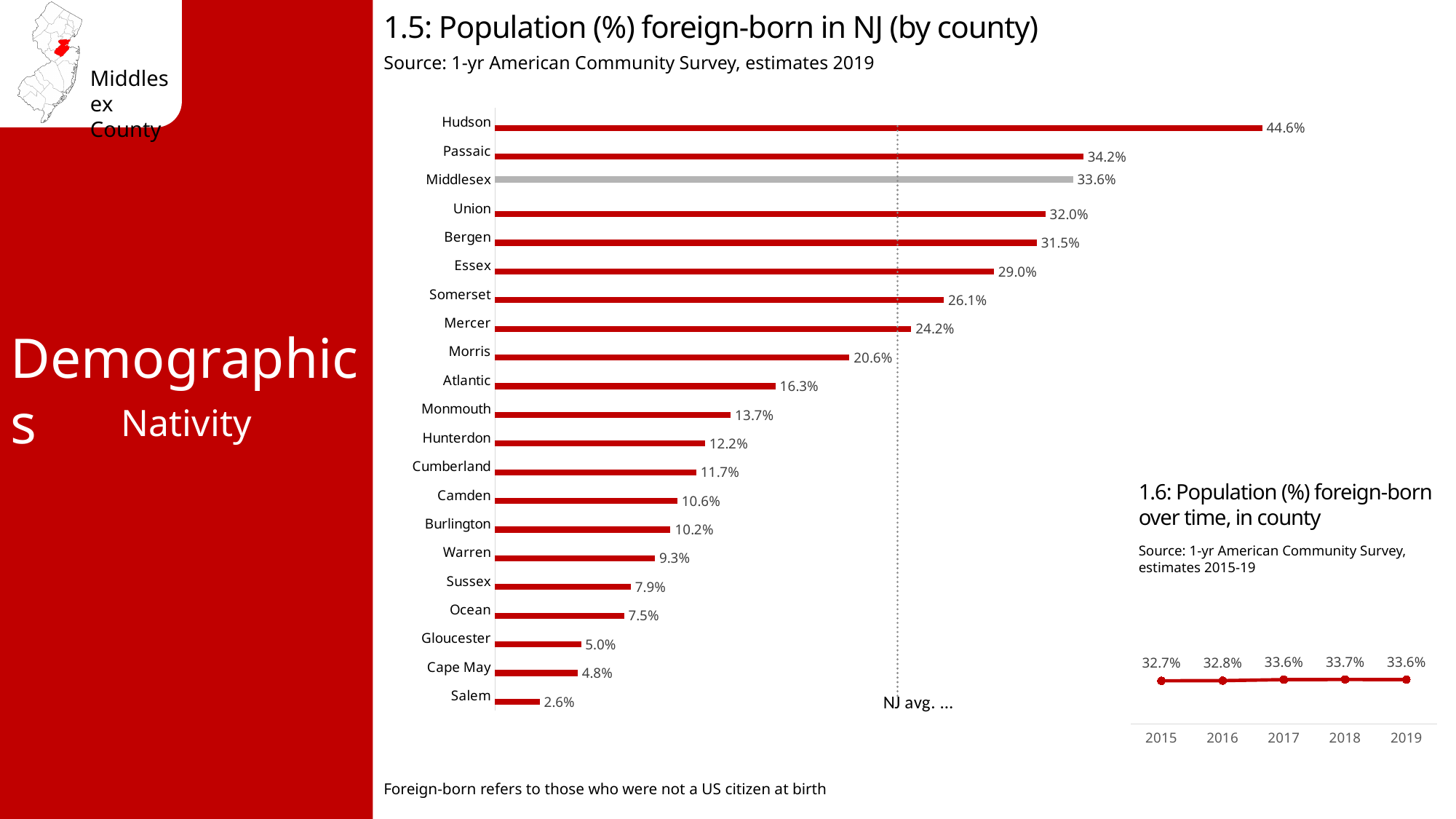
In the chart '1.6: Population (%) foreign-born over time, in county', which year has the highest value? 2018 What kind of chart is '1.5: Population (%) foreign-born in NJ (by county)'? Bar chart In the chart '1.5: Population (%) foreign-born in NJ (by county)', which county has the highest value? Hudson In the chart '1.6: Population (%) foreign-born over time, in county', how many years are plotted? 5 In the chart '1.6: Population (%) foreign-born over time, in county', what is the value for 2015? 32.7% In the chart '1.5: Population (%) foreign-born in NJ (by county)', what is the value for Mercer? 24.2% In the chart '1.5: Population (%) foreign-born in NJ (by county)', which county's bar is shown in grey rather than red? Middlesex In the chart '1.5: Population (%) foreign-born in NJ (by county)', which county has the lowest value? Salem In the chart '1.5: Population (%) foreign-born in NJ (by county)', what is the difference between Hudson and Passaic? 10.4% In the chart '1.5: Population (%) foreign-born in NJ (by county)', which is larger, Bergen or Essex? Bergen In the chart '1.5: Population (%) foreign-born in NJ (by county)', what is the value for Middlesex? 33.6% In the chart '1.5: Population (%) foreign-born in NJ (by county)', how many counties are plotted? 21